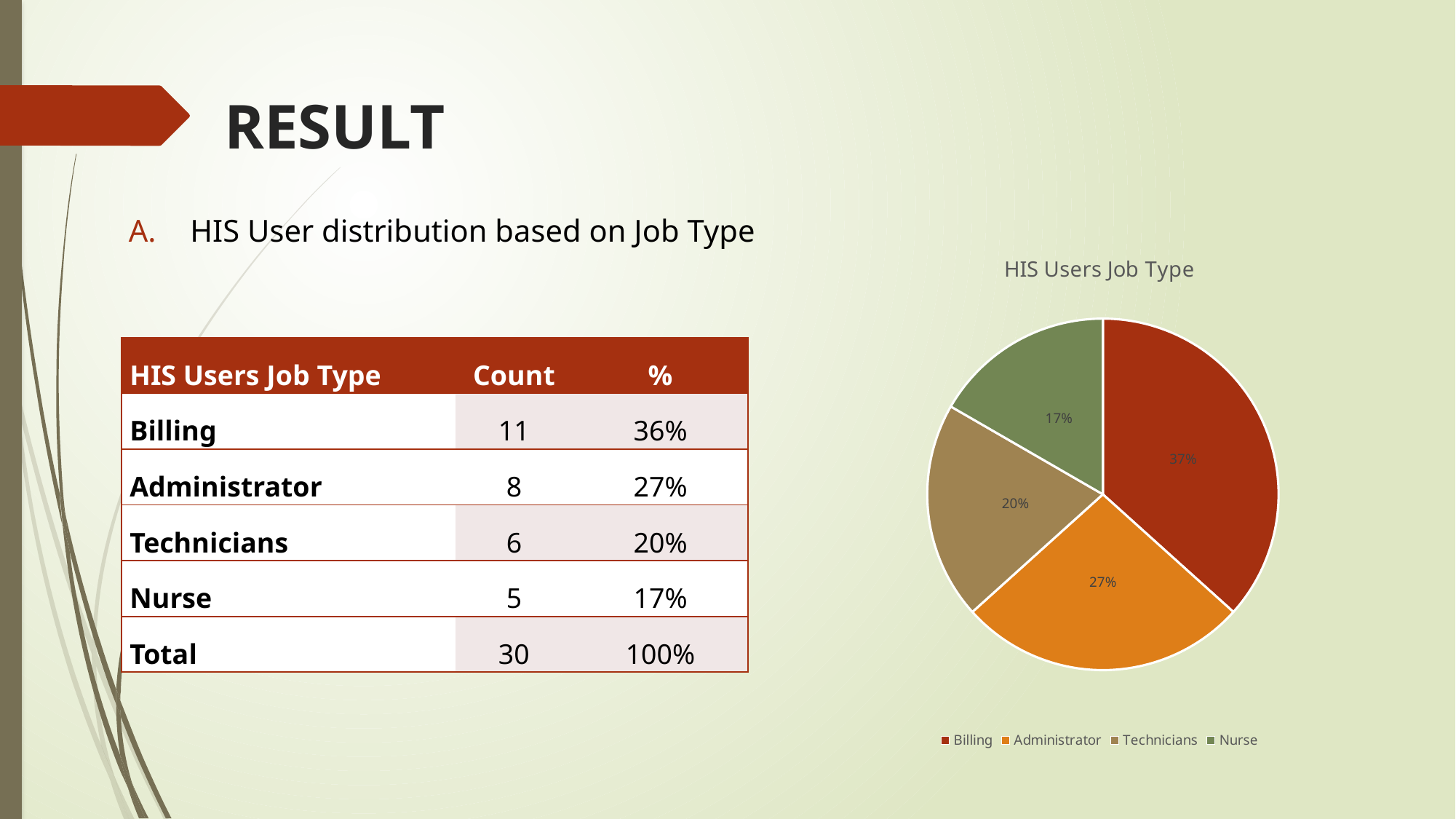
In the pie chart, which slice is larger, Administrator or Technicians? Administrator What type of chart is shown on the slide? pie chart What percentage does the pie chart show for Billing? 37% What percentage does the pie chart show for Technicians? 20% How many slices does the pie chart have? 4 What percentage does the pie chart show for Nurse? 17% What is the title of the chart? HIS Users Job Type Which job type has the smallest slice in the pie chart? Nurse In the pie chart, what is the difference in percentage points between the Billing slice and the Nurse slice? 20 Which job type has the largest slice in the pie chart? Billing How many entries does the chart legend list? 4